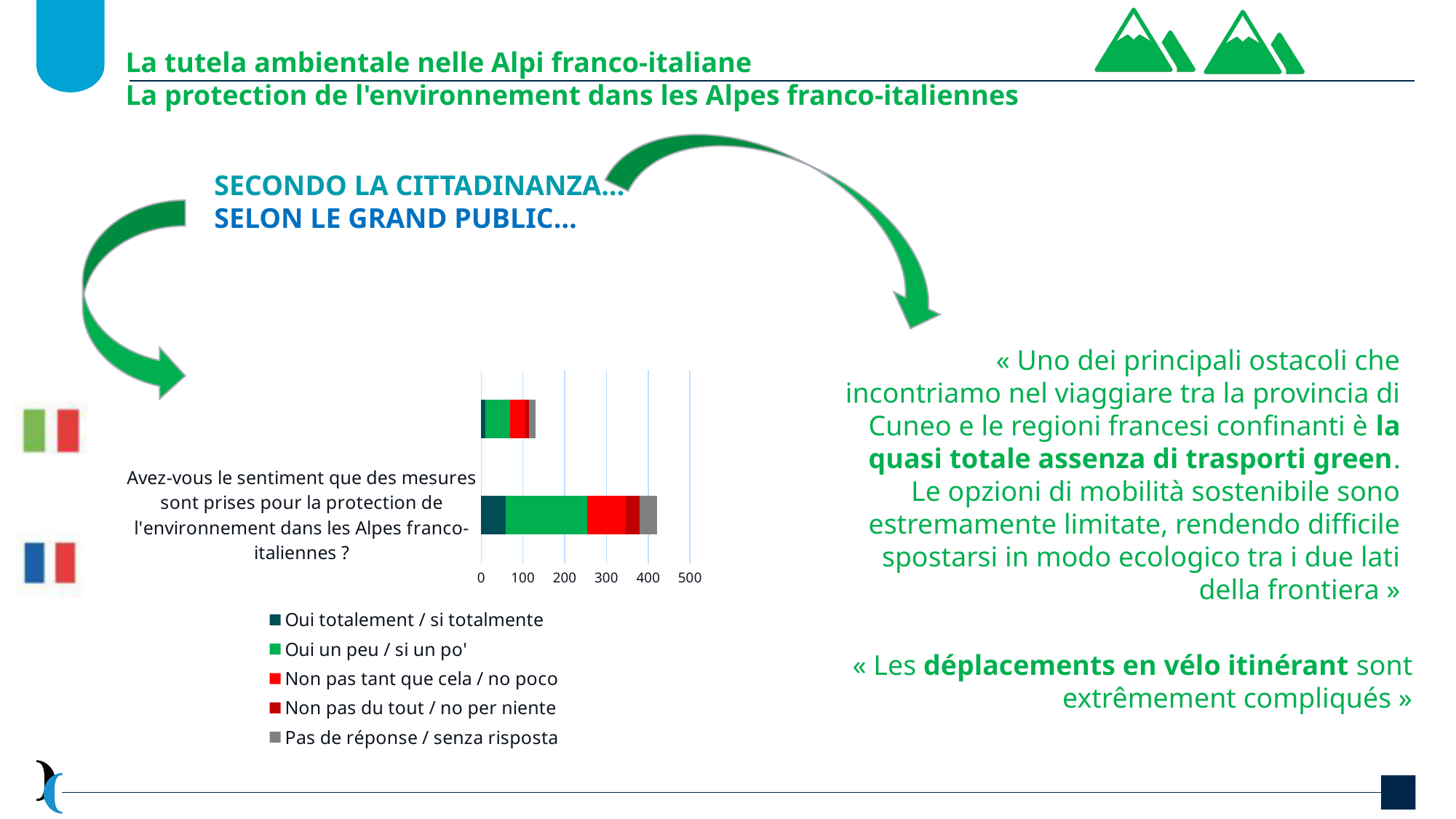
What is the highest value shown on the chart's horizontal axis? 500 Which legend entry is shown in grey? Pas de réponse / senza risposta Which series forms the largest segment of the bottom bar? Oui un peu / si un po' Which bar is longer, the top bar or the bottom bar? the bottom bar How many bars are plotted in the chart? 2 How many series does the chart legend list? 5 What kind of chart is shown on the slide? bar chart Is the total length of the top bar greater or less than 200? less Is the total length of the bottom bar greater or less than 400? greater